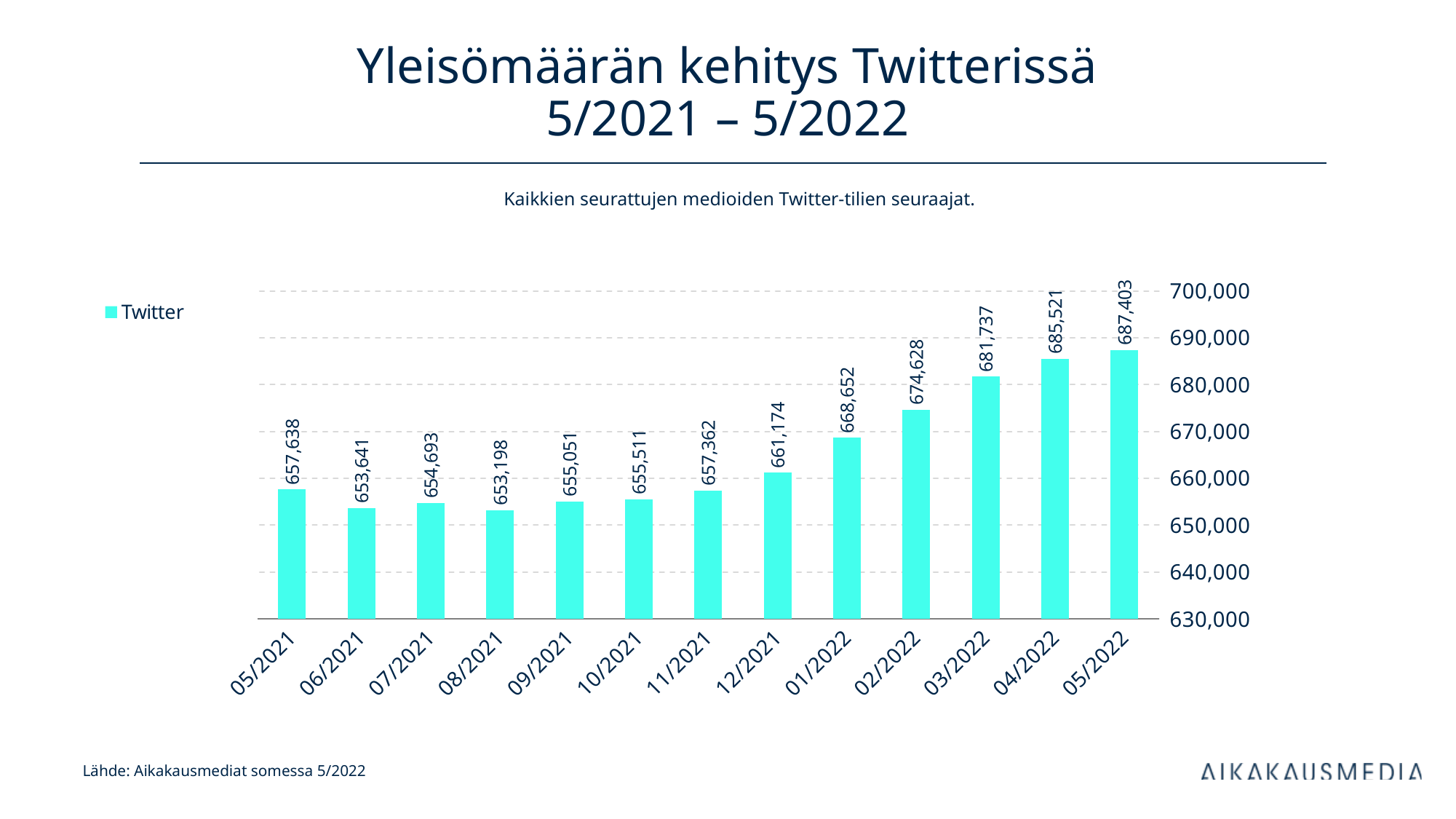
Which month has the lowest value? 08/2021 How many months are shown on the x axis? 13 What is the value for 05/2022? 687,403 What is the difference between the values for 04/2022 and 03/2022? 3,784 What is the value for 01/2022? 668,652 What kind of chart is shown on the slide? bar chart What is the difference between the values for 05/2022 and 05/2021? 29,765 Which month has the highest value? 05/2022 Which is larger, the value for 12/2021 or the value for 11/2021? 12/2021 Do the values generally rise or fall from 12/2021 to 05/2022? rise Is the value for 02/2022 greater or less than 670,000? greater What is the value for 05/2021? 657,638